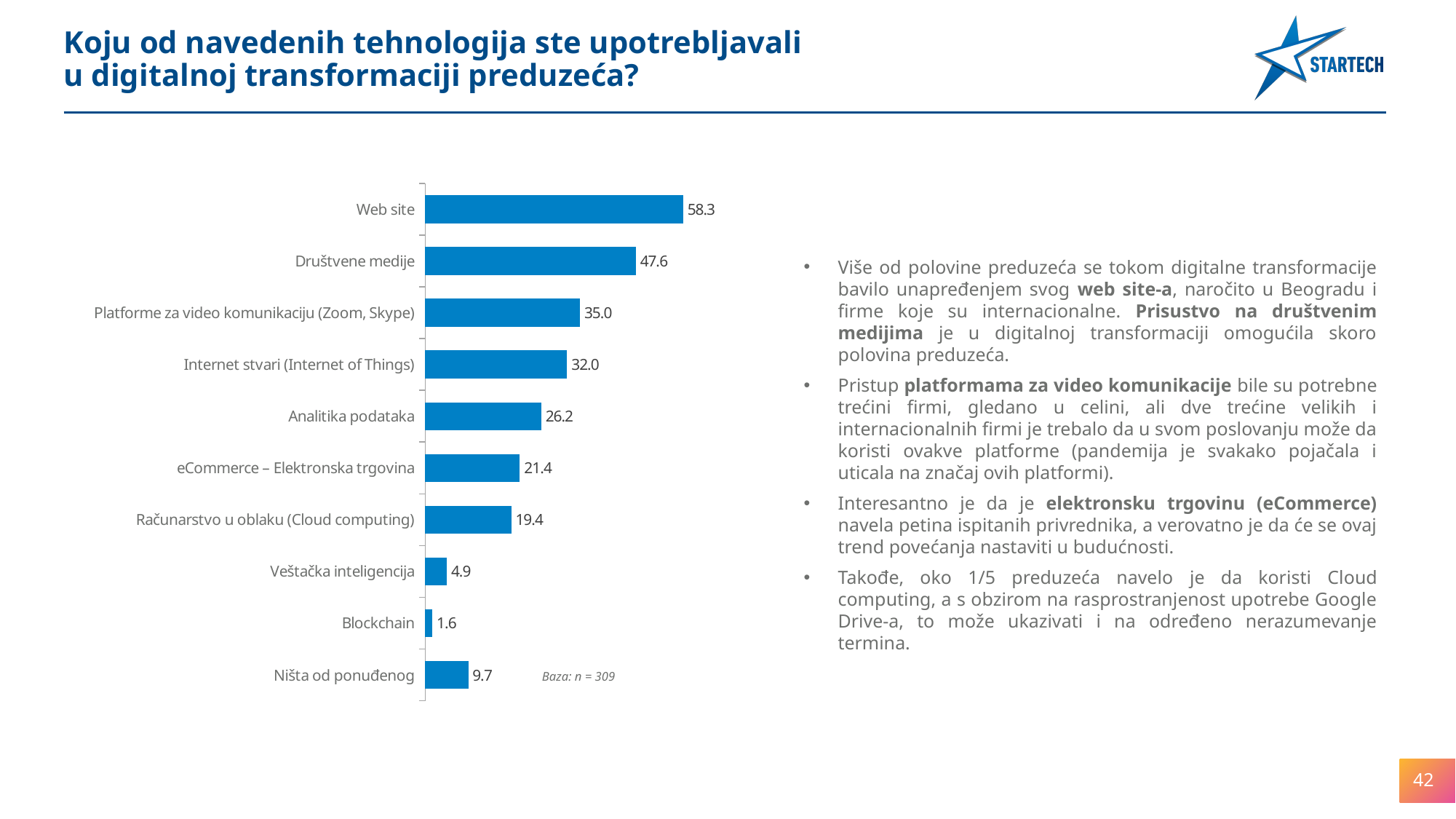
How many categories are shown in the chart? 10 Which is larger, the value for Platforme za video komunikaciju (Zoom, Skype) or the value for Internet stvari (Internet of Things)? Platforme za video komunikaciju (Zoom, Skype) What is the sample size (Baza) noted on the chart? n = 309 What is the difference between the values for Web site and Društvene medije? 10.7 What is the value for Web site? 58.3 What is the value for Ništa od ponuđenog? 9.7 What is the value for Računarstvo u oblaku (Cloud computing)? 19.4 What kind of chart is shown on the slide? Bar chart Which category has the highest value? Web site Which category has the lowest value? Blockchain What is the difference between the values for Analitika podataka and eCommerce – Elektronska trgovina? 4.8 Which is larger, the value for Veštačka inteligencija or the value for Ništa od ponuđenog? Ništa od ponuđenog